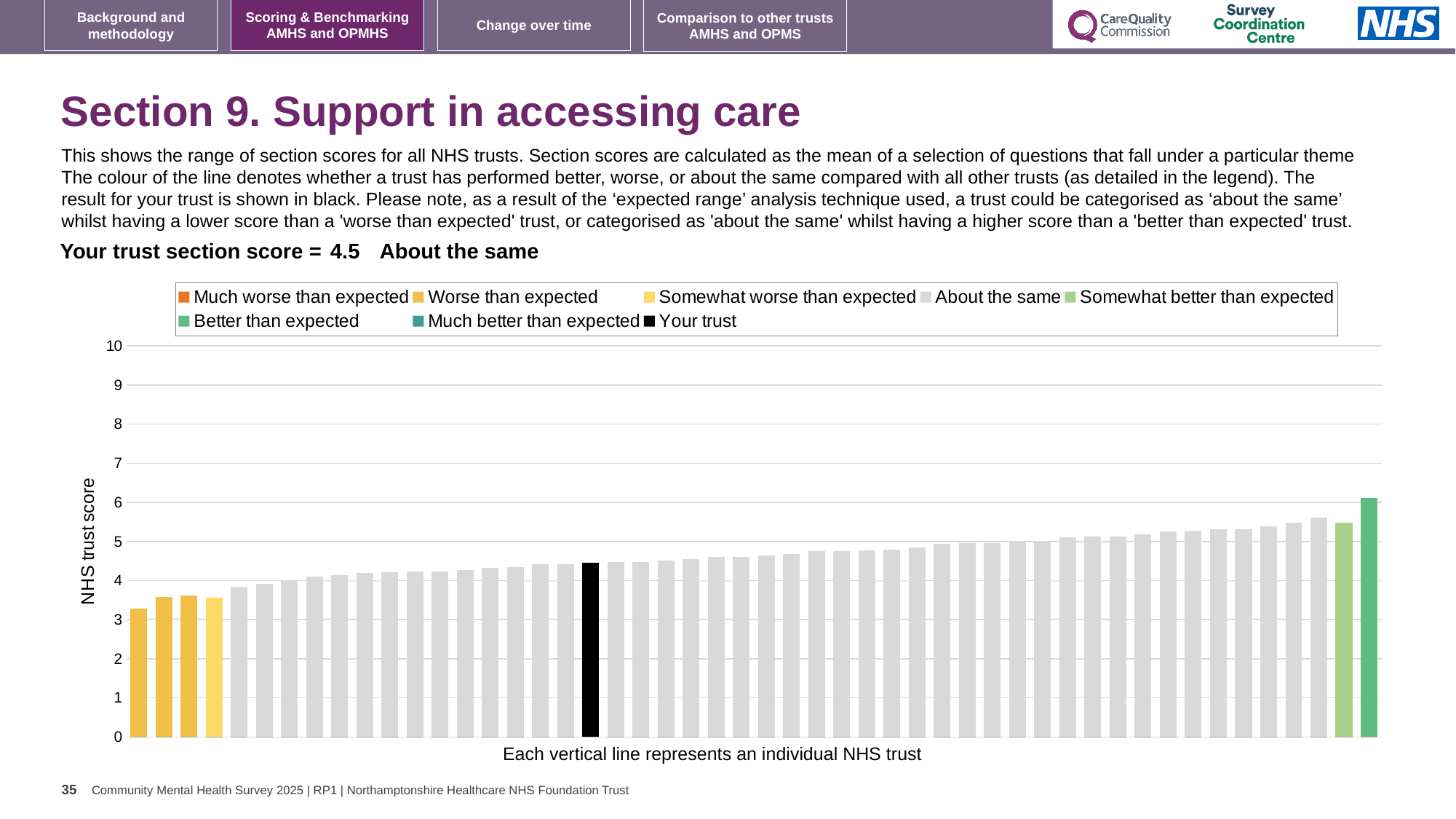
Which category is your trust placed in for this section? About the same Is the value of the black bar (your trust) greater or less than 4? greater What kind of chart is shown on the slide? Bar chart Which legend category does the highest (rightmost) bar belong to? Better than expected What colour is used for the bar representing your trust? Black What is the label on the vertical axis of the chart? NHS trust score Is the value of the lowest bar greater or less than 4? less Do the bar values rise or fall from left to right along the x axis? Rise How many entries does the chart legend list? 8 What is the section score for your trust shown on the slide? 4.5 Is the value of the black bar (your trust) greater or less than 5? less